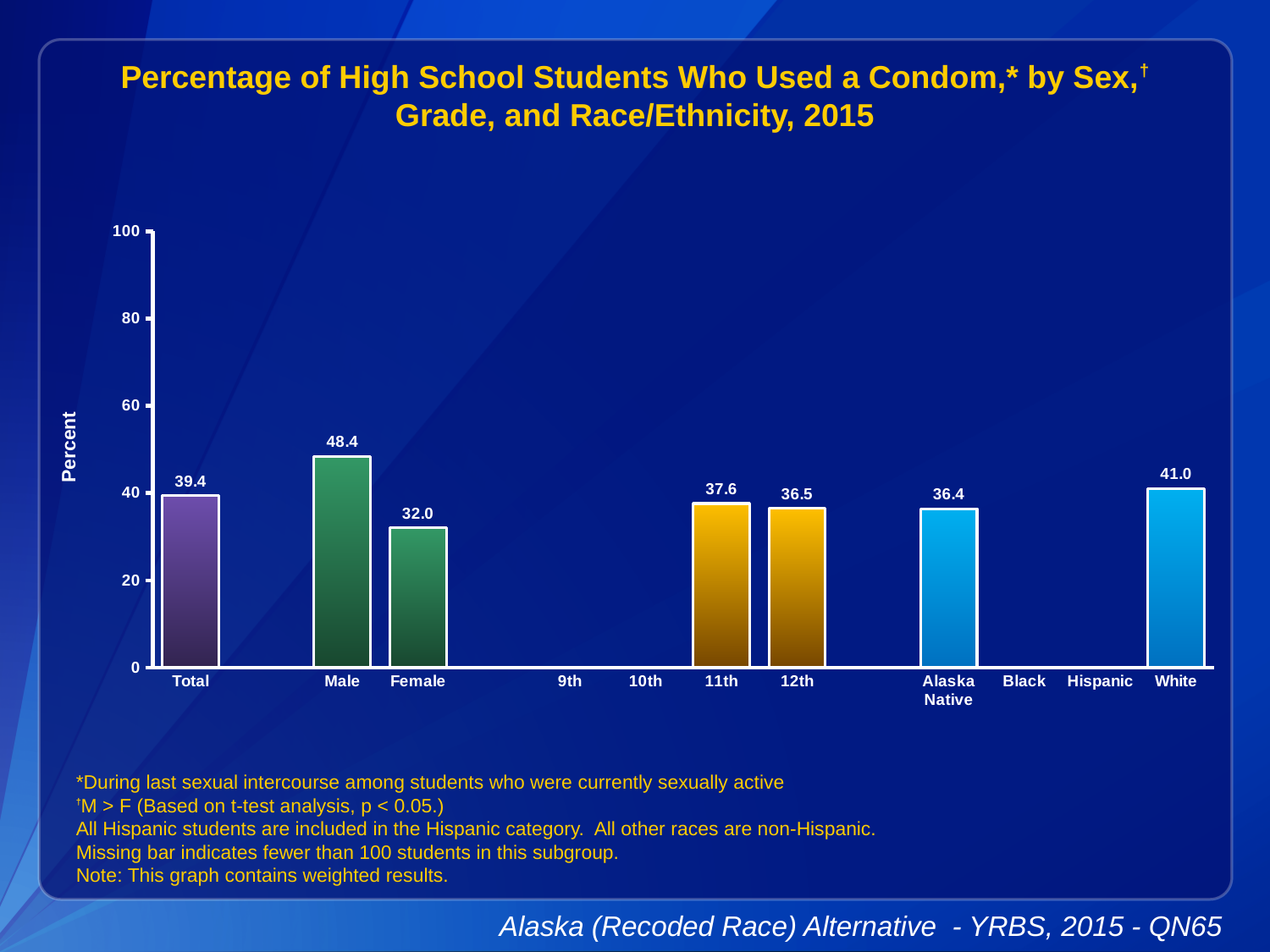
Which category with a bar has the lowest value? Female What is the value for Alaska Native? 36.4 How many categories have a bar shown? 8 What is the value for White? 41.0 What is the label on the y axis? Percent What is the difference between the Male and Female values? 16.4 What is the value for Female? 32.0 Which is larger, the value for 11th or the value for 12th? 11th What kind of chart is this? bar chart What is the value for Male? 48.4 Is the value for Total greater or less than 40? less Which category has the highest value? Male